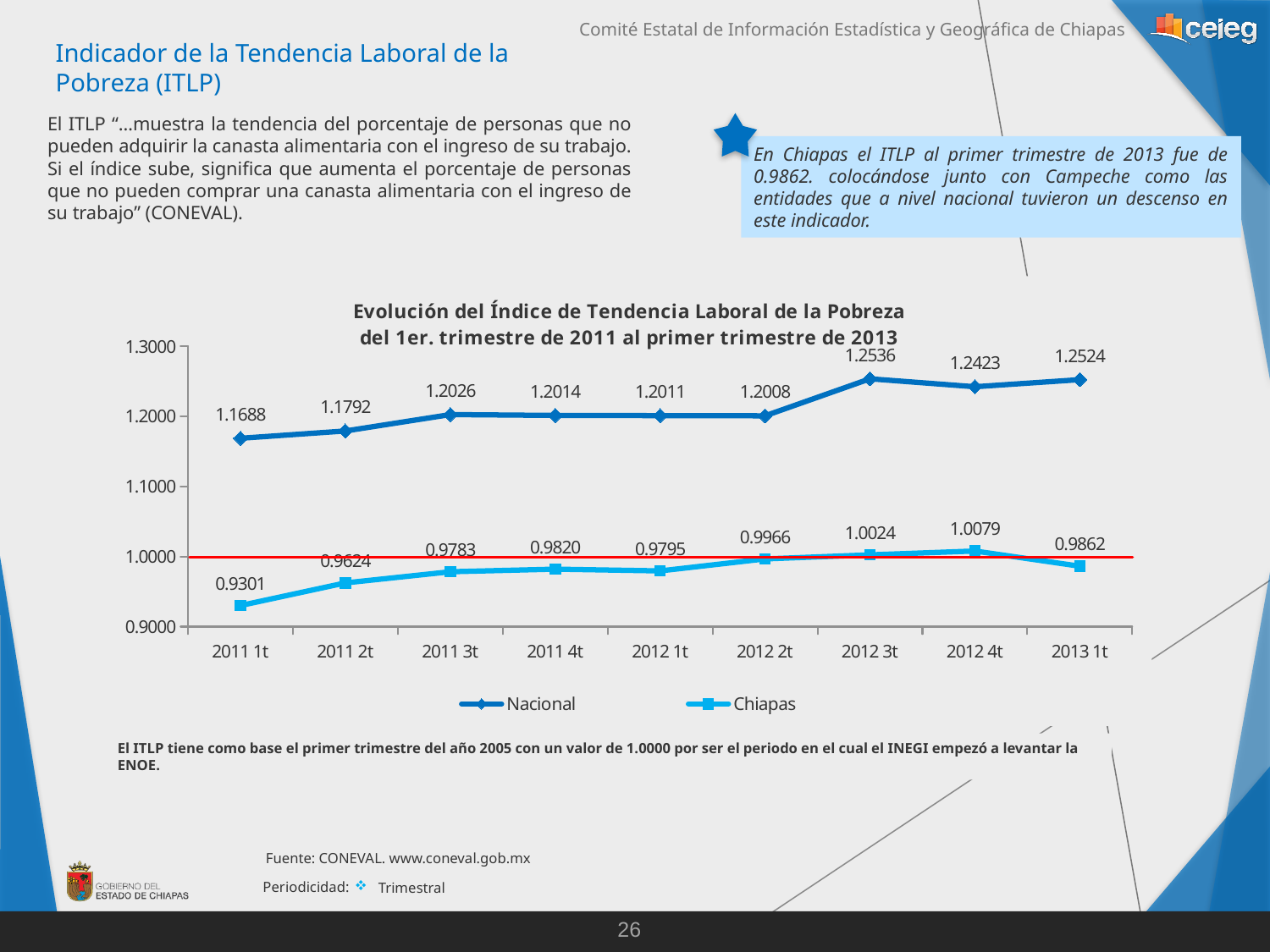
What is the title of the chart? Evolución del Índice de Tendencia Laboral de la Pobreza del 1er. trimestre de 2011 al primer trimestre de 2013 How many quarters are plotted along the x axis? 9 Which series has the larger value in 2011 3t, Nacional or Chiapas? Nacional How many series does the legend list? 2 What is the Nacional value for 2011 1t? 1.1688 What is the difference between the Nacional and Chiapas values for 2012 4t? 0.2344 In which quarter does the Chiapas series have its lowest value? 2011 1t What is the Chiapas value for 2012 2t? 0.9966 Is the Chiapas value for 2012 4t greater or less than 1.0000? greater What is the Chiapas value for 2013 1t? 0.9862 What type of chart is shown on the slide? Line chart In which quarter does the Nacional series reach its highest value? 2012 3t